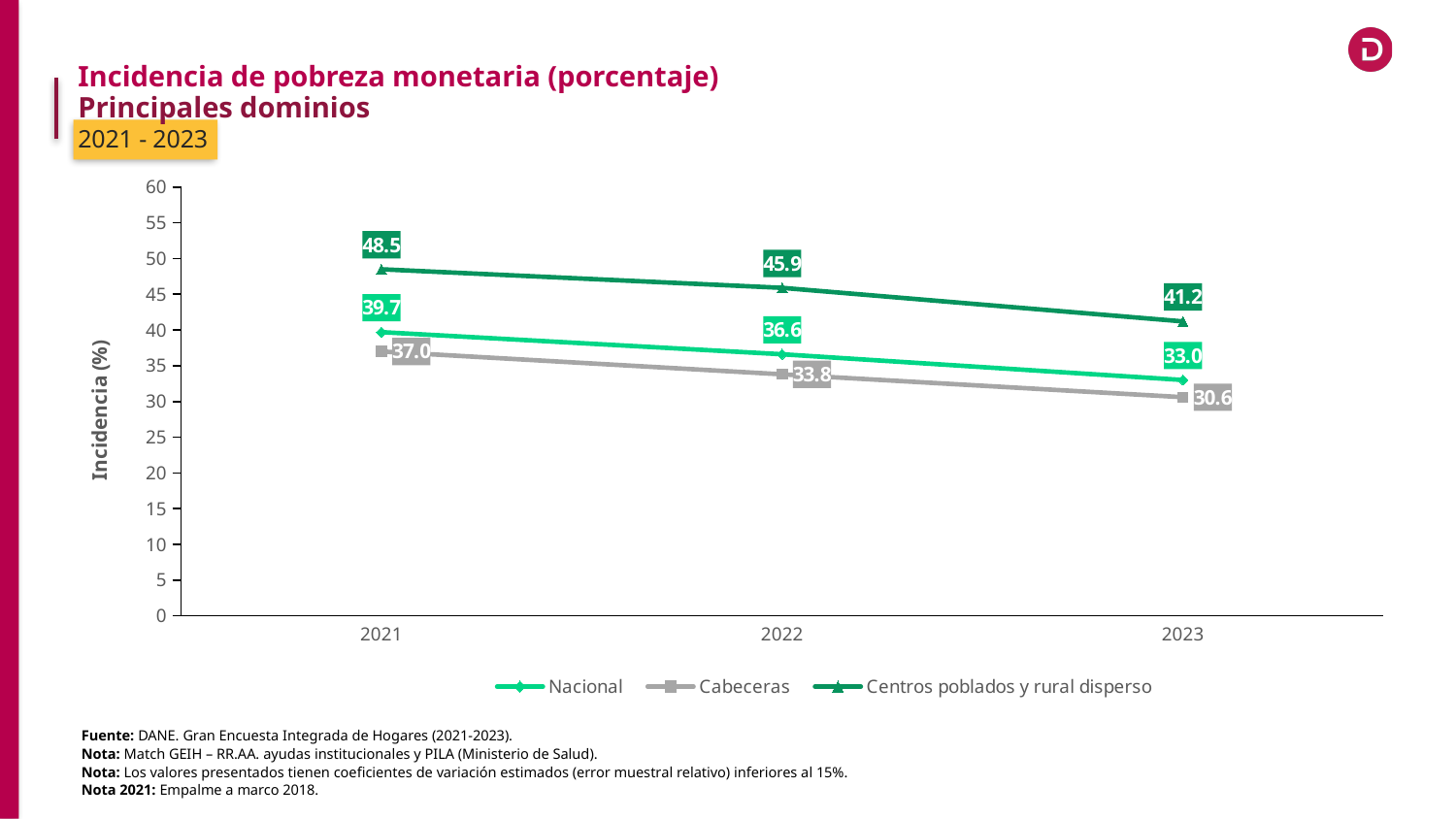
Do the Nacional values rise or fall from 2021 to 2023? Fall Which is larger: the Nacional value in 2021 or the Cabeceras value in 2021? Nacional value in 2021 What kind of chart is shown on the slide? Line chart Which series has the lowest value in 2021? Cabeceras What is the value for Centros poblados y rural disperso in 2021? 48.5 Which series has the highest value in 2023? Centros poblados y rural disperso What is the value for Nacional in 2022? 36.6 What is the value for Cabeceras in 2023? 30.6 How many years are shown on the x axis? 3 Is the value for Centros poblados y rural disperso in 2023 greater or less than 40? greater What is the difference between the Centros poblados y rural disperso value and the Nacional value in 2022? 9.3 How many series does the legend list? 3